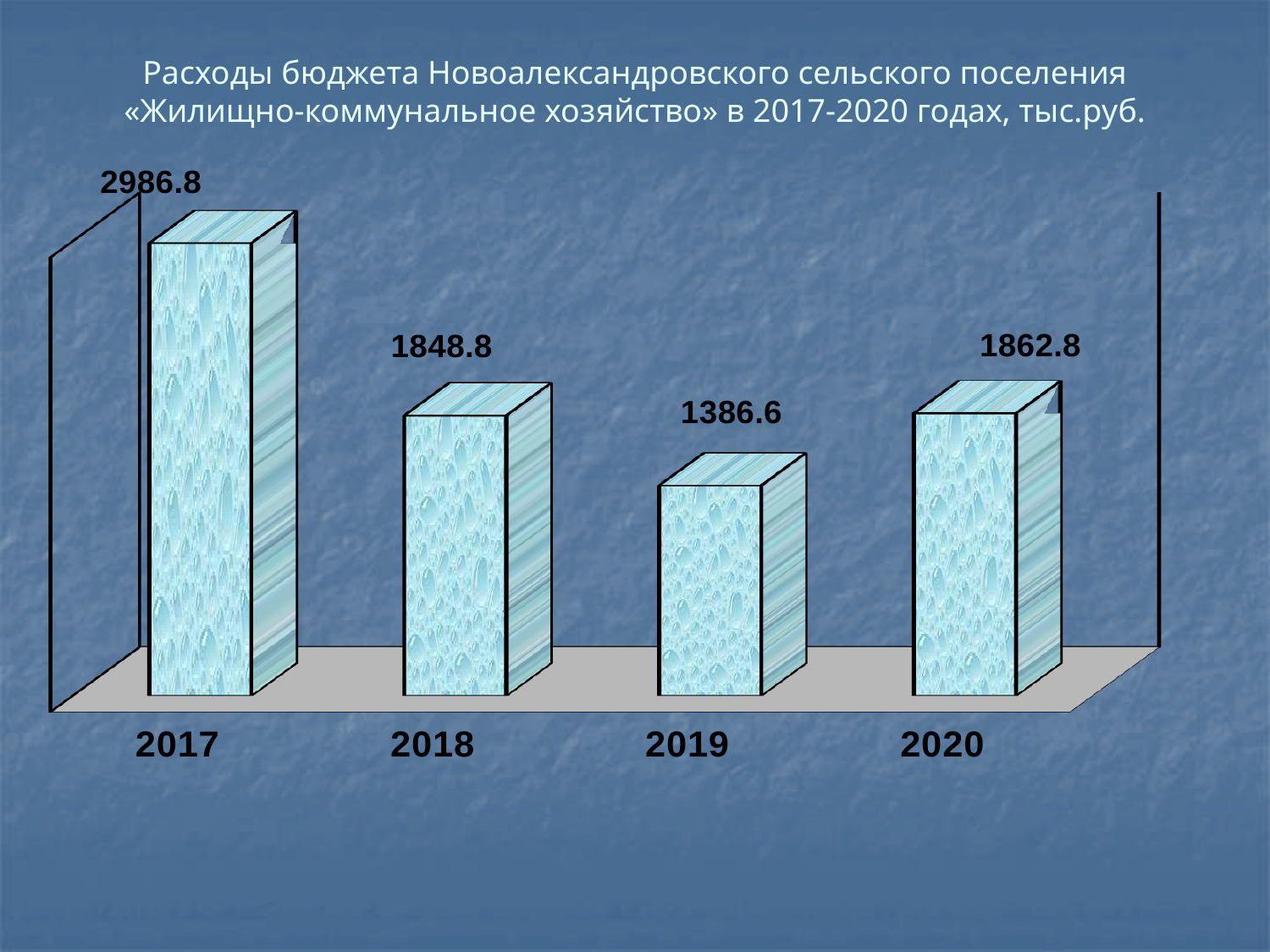
What is the value for 2019? 1386.6 What kind of chart is shown on the slide? bar chart How many years are shown on the chart? 4 Which year has the lowest value? 2019 What is the difference between the values for 2020 and 2019? 476.2 Which year has the highest value? 2017 What is the value for 2018? 1848.8 Which is larger, the value for 2017 or the value for 2020? 2017 What is the value for 2017? 2986.8 What is the difference between the values for 2017 and 2018? 1138.0 What is the value for 2020? 1862.8 Do the values rise or fall from 2017 to 2019? fall